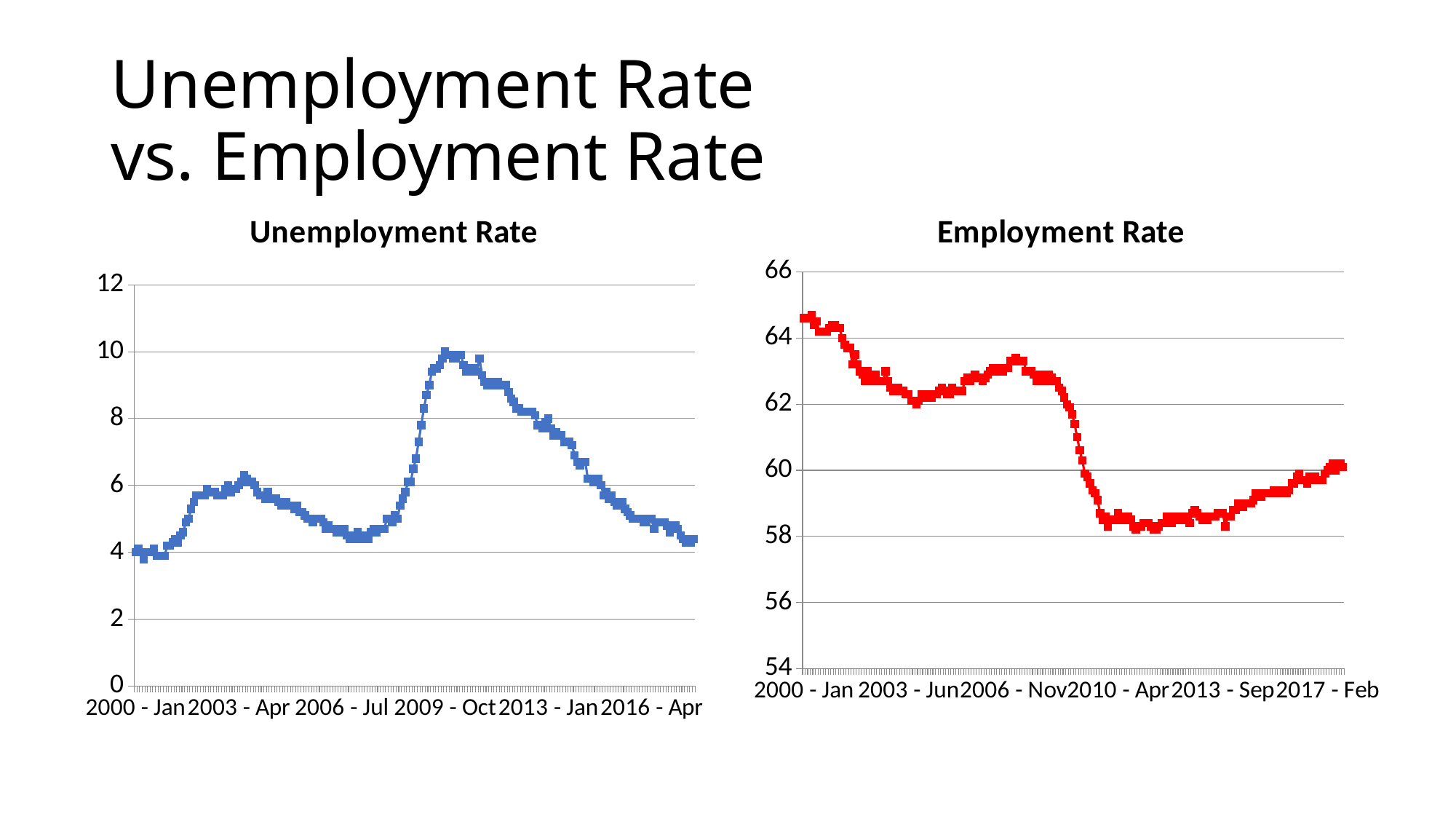
What is the highest value shown on the y axis of the Employment Rate chart? 66 In the Employment Rate chart, is the value at 2010 - Apr greater or less than 60? less In the Unemployment Rate chart, is the peak value reached around 2009 - Oct greater or less than 8? greater In the Unemployment Rate chart, do the values rise or fall between 2009 - Oct and 2016 - Apr? fall In the Employment Rate chart, is the value at 2000 - Jan greater or less than 64? greater In the Employment Rate chart, do the values rise or fall between 2010 - Apr and 2017 - Feb? rise In the Unemployment Rate chart, do the values rise or fall between 2006 - Jul and 2009 - Oct? rise What kind of chart is the Unemployment Rate chart? line chart What colour is the line in the Employment Rate chart? red What kind of chart is the Employment Rate chart? line chart